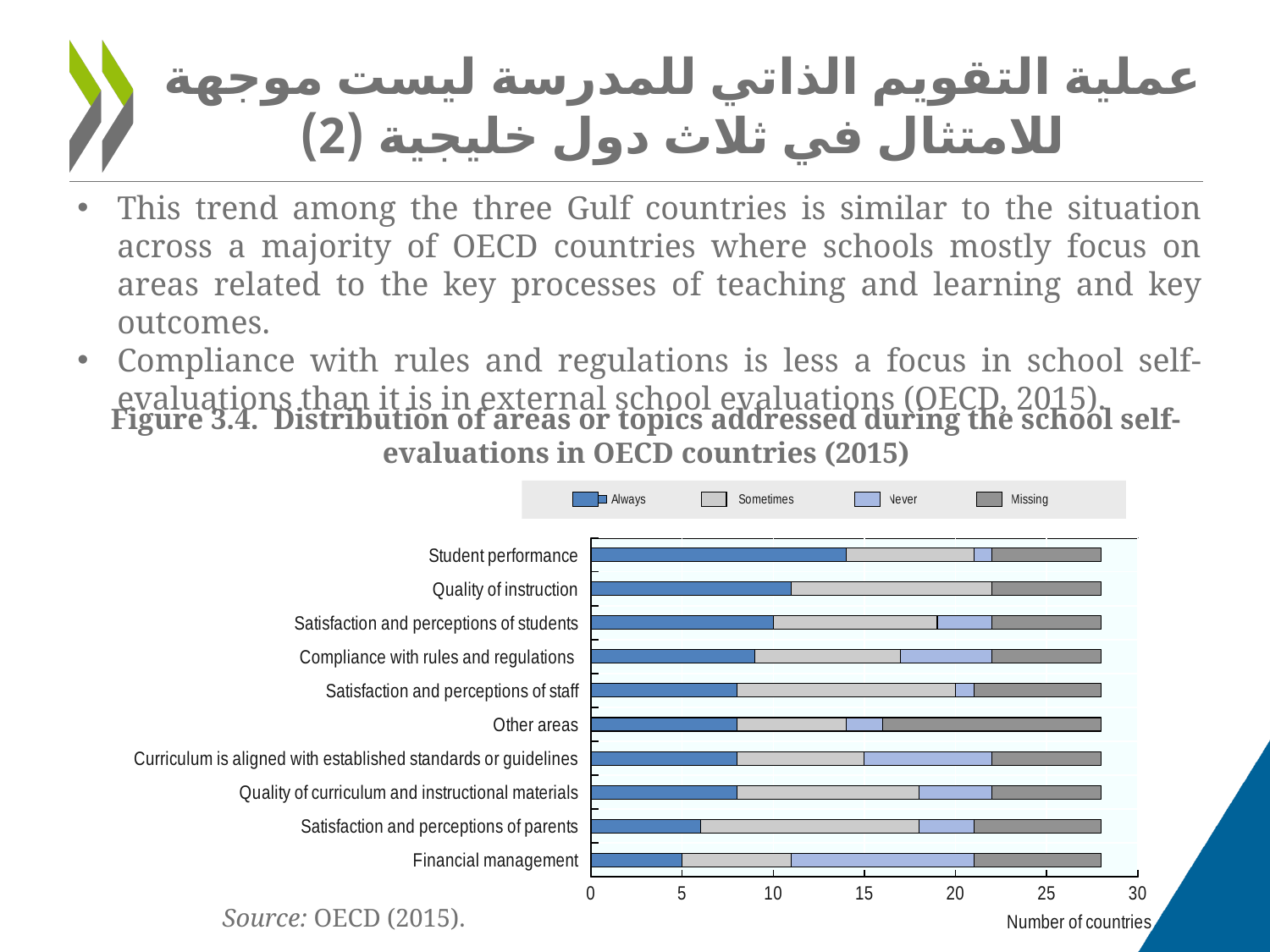
Is the 'Always' value for Satisfaction and perceptions of parents greater or less than 10? less Is the 'Always' value for Student performance greater or less than 10? greater Which area has the shortest 'Always' segment in the chart? Financial management Which has a larger 'Always' segment: Quality of instruction or Satisfaction and perceptions of parents? Quality of instruction Is the 'Always' value for Financial management greater or less than 10? less How many series does the chart's legend list? 4 What are the four legend entries of the chart? Always, Sometimes, Never, Missing How many areas or topics are listed on the vertical axis of the chart? 10 Which has a larger 'Always' segment: Student performance or Financial management? Student performance What kind of chart is shown in Figure 3.4? Stacked bar chart What is the label of the horizontal axis of the chart? Number of countries Which area has the longest 'Always' segment in the chart? Student performance